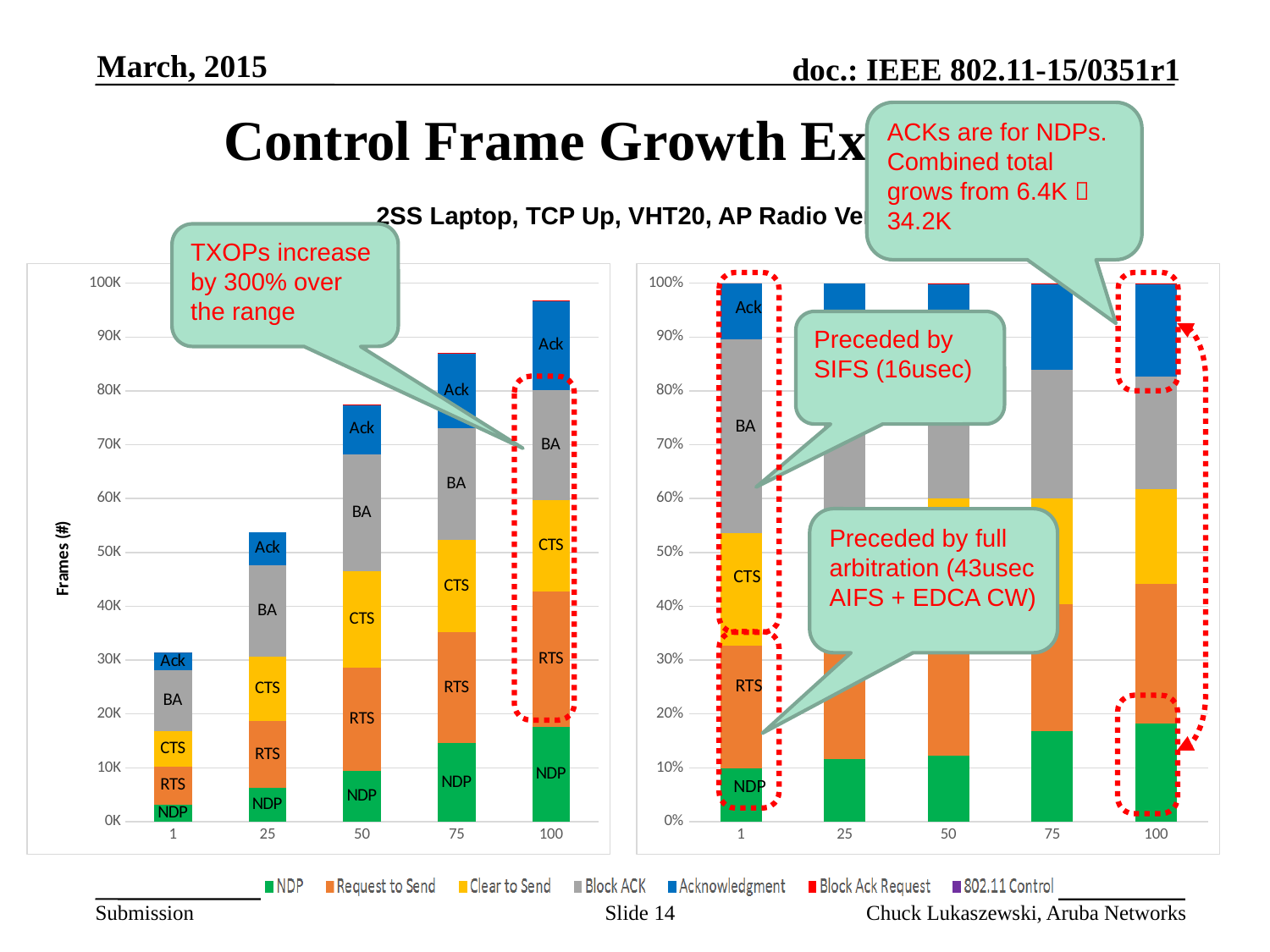
In the left chart, is the total height of the bar for 100 greater or less than 90K? greater In the left chart, which x-axis category has the tallest stacked bar? 100 What is the y-axis label of the left chart? Frames (#) In the left chart, is the total height of the bar for 50 greater or less than 70K? greater How many series does the legend at the bottom of the slide list? 7 In the left chart, do the total bar heights rise or fall as the x-axis value increases from 1 to 100? rise In the right chart, is the NDP share of the bar for 100 greater or less than 10%? greater In the left chart, is the total bar for 75 larger or smaller than the total bar for 50? larger In the left chart, which x-axis category has the shortest stacked bar? 1 What kind of chart is the left chart on the slide? stacked bar chart How many categories are shown on the x axis of the left chart? 5